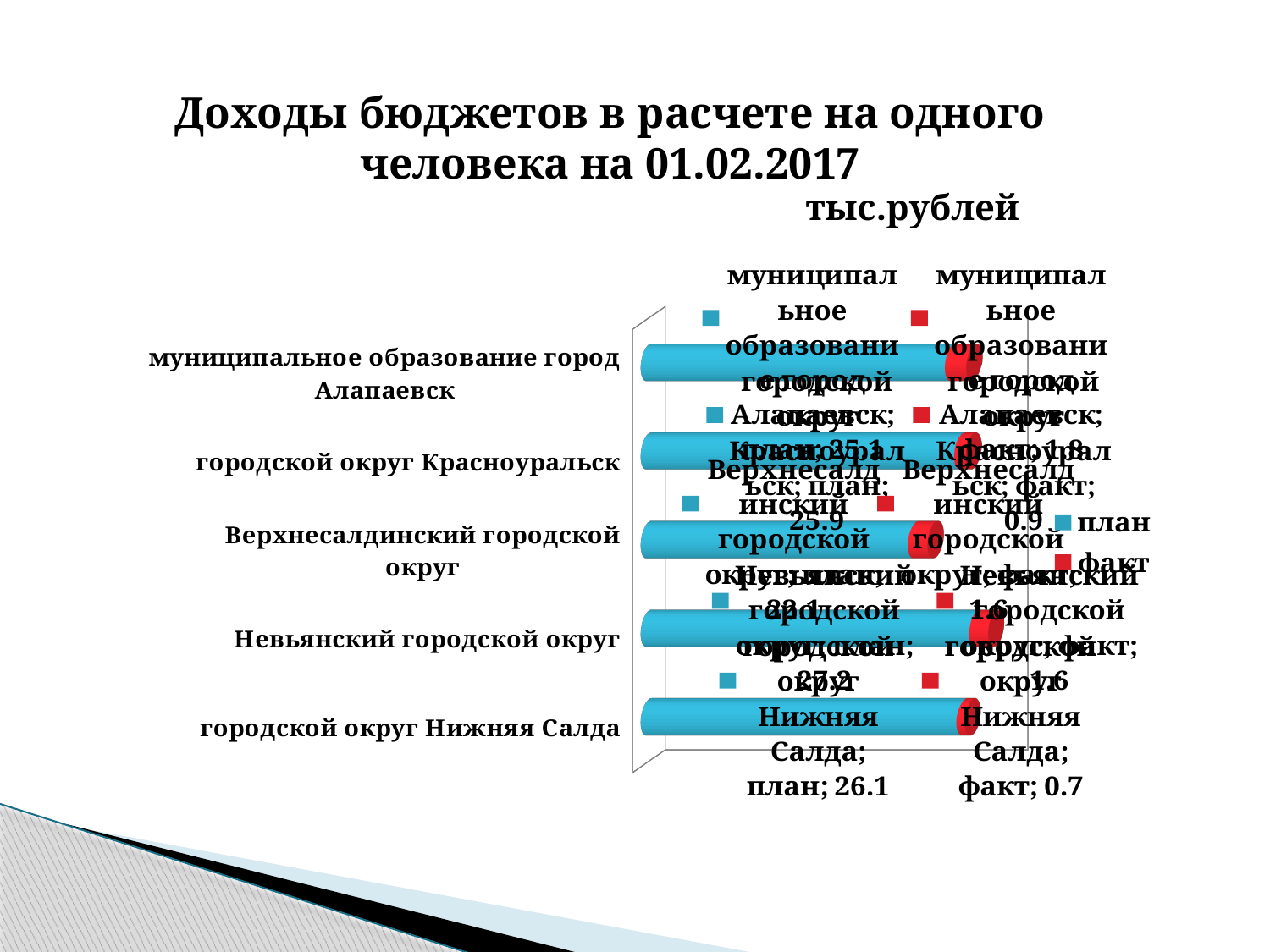
Which colour represents the 'план' series in the chart? blue How many municipalities (categories) are shown on the chart? 5 What is the difference between the 'план' and 'факт' values for городской округ Нижняя Салда? 25.4 How many series does the chart legend list? 2 What is the 'факт' value for Верхнесалдинский городской округ? 1.6 What is the 'факт' value for городской округ Нижняя Салда? 0.7 What kind of chart is shown on the slide? bar chart What is the 'план' value for Верхнесалдинский городской округ? 22.1 For городской округ Нижняя Салда, which is larger: the 'план' value or the 'факт' value? план Which has the larger 'факт' value: муниципальное образование город Алапаевск or Верхнесалдинский городской округ? муниципальное образование город Алапаевск What is the 'план' value for городской округ Нижняя Салда? 26.1 What are the two series named in the chart legend? план and факт